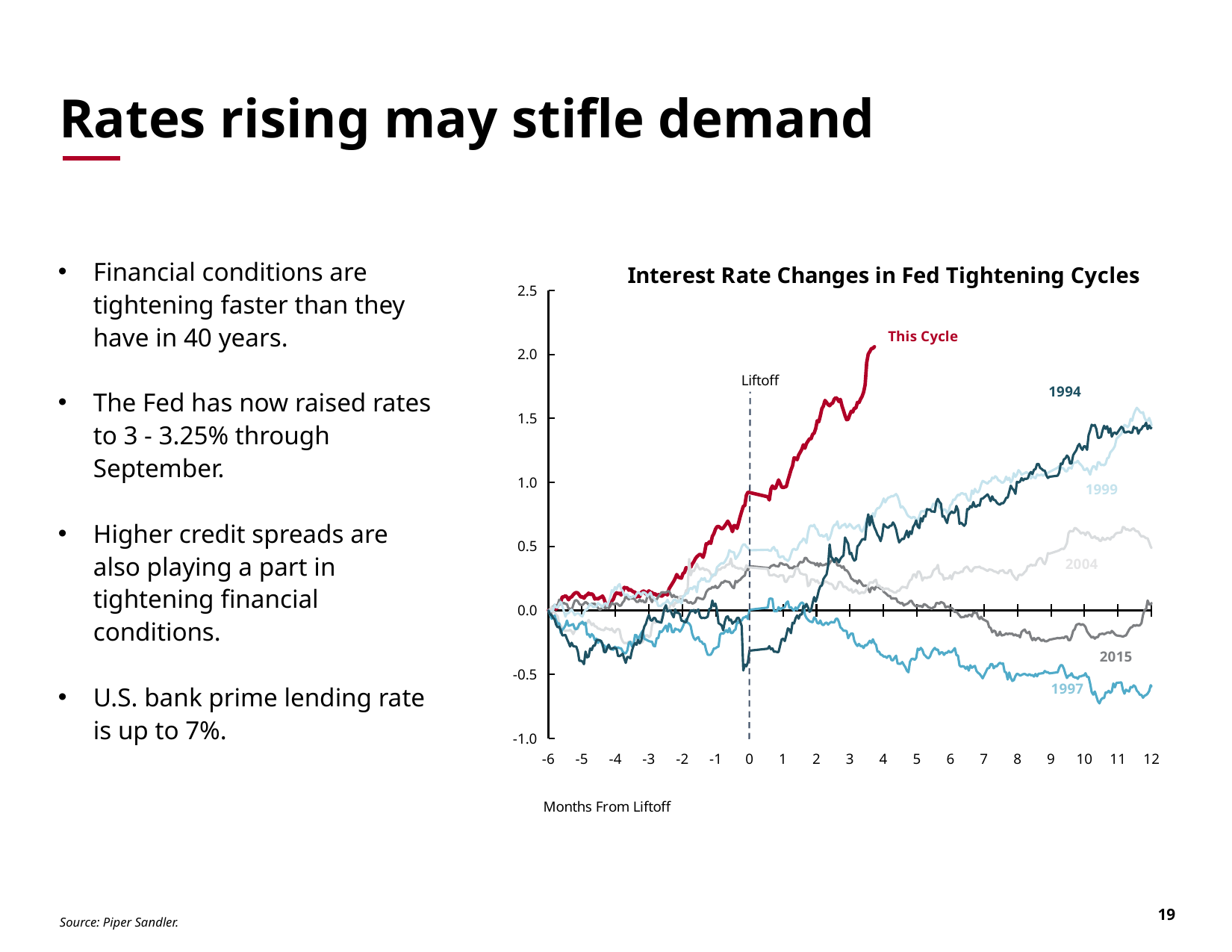
What is the label of the x axis? Months From Liftoff Is the value for 2015 at month 8 greater or less than 0.0? less Is the value for 1994 at month 6 greater or less than 0.5? greater How many series (cycles) are labelled on the chart? 6 Which series is lowest at month 12? 1997 Does the 1997 series generally rise or fall after liftoff? Fall Which series reaches the highest value on the chart? This Cycle What is the title of the chart? Interest Rate Changes in Fed Tightening Cycles What kind of chart is shown on the slide? Line chart Is the value for This Cycle at month 2 greater or less than 1.0? greater At month 12, is the value for 1994 larger or smaller than the value for 2015? Larger